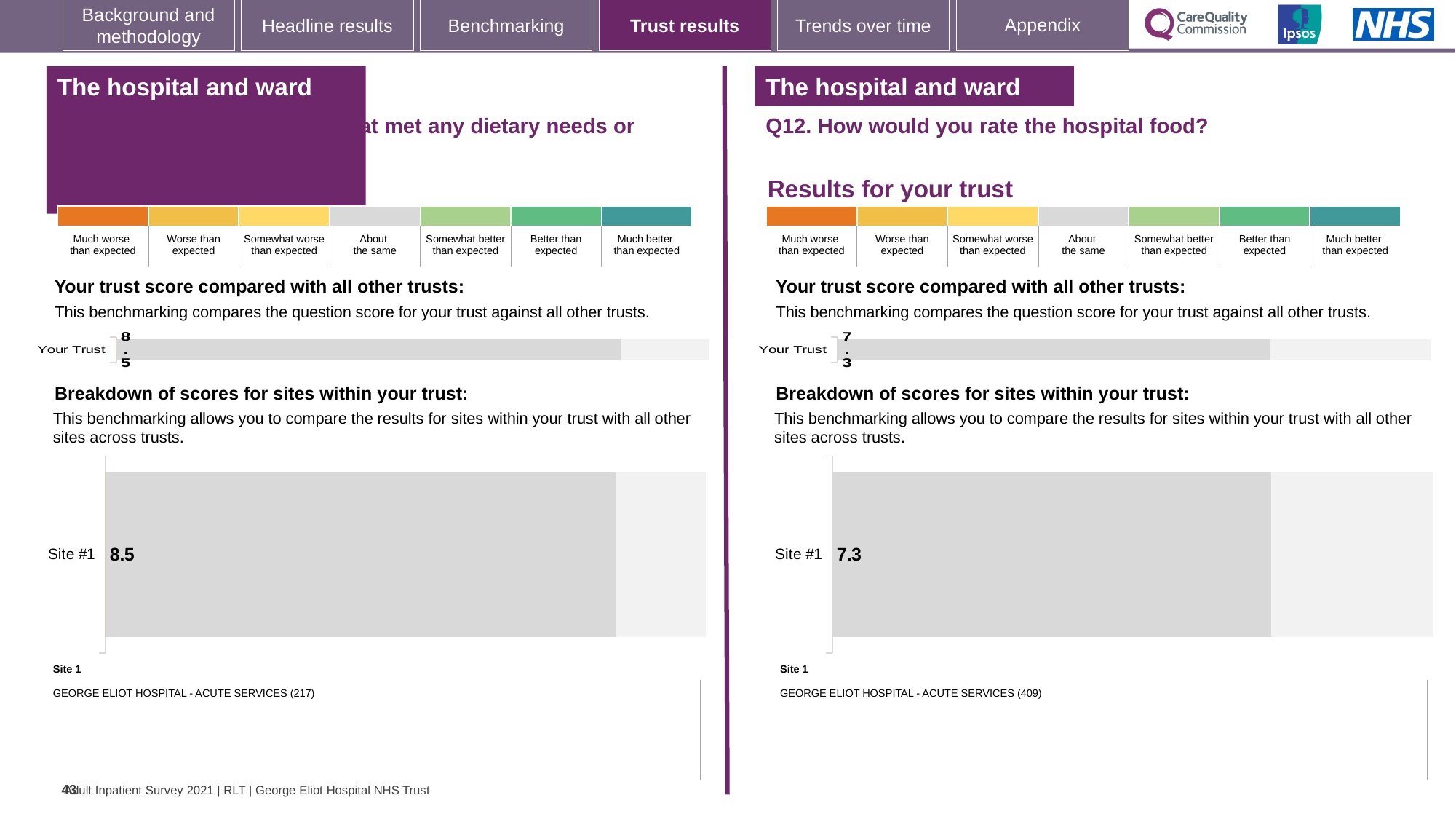
On the right-hand 'Breakdown of scores for sites within your trust' chart for Q12 (hospital food), what is the value for Site #1? 7.3 On the right-hand 'Your trust score compared with all other trusts' chart for Q12 (hospital food), what is the value for Your Trust? 7.3 What is the question text shown above the right-hand charts? Q12. How would you rate the hospital food? On the left-hand 'Your trust score compared with all other trusts' chart, what is the value for Your Trust? 8.5 On the left-hand 'Breakdown of scores for sites within your trust' chart, what is the value for Site #1? 8.5 Which site name is listed under the right-hand breakdown chart for Q12 as Site 1? GEORGE ELIOT HOSPITAL - ACUTE SERVICES (409) What kind of chart is the 'Breakdown of scores for sites within your trust' chart on the right-hand side? Bar chart How many sites are plotted on the right-hand 'Breakdown of scores for sites within your trust' chart for Q12? 1 What is the difference between the Your Trust score on the left-hand chart and the Your Trust score on the right-hand Q12 chart? 1.2 Which is larger: the Site #1 score on the left-hand breakdown chart or the Site #1 score on the right-hand breakdown chart for Q12? Left-hand Site #1 (8.5) How many sites are plotted on the left-hand 'Breakdown of scores for sites within your trust' chart? 1